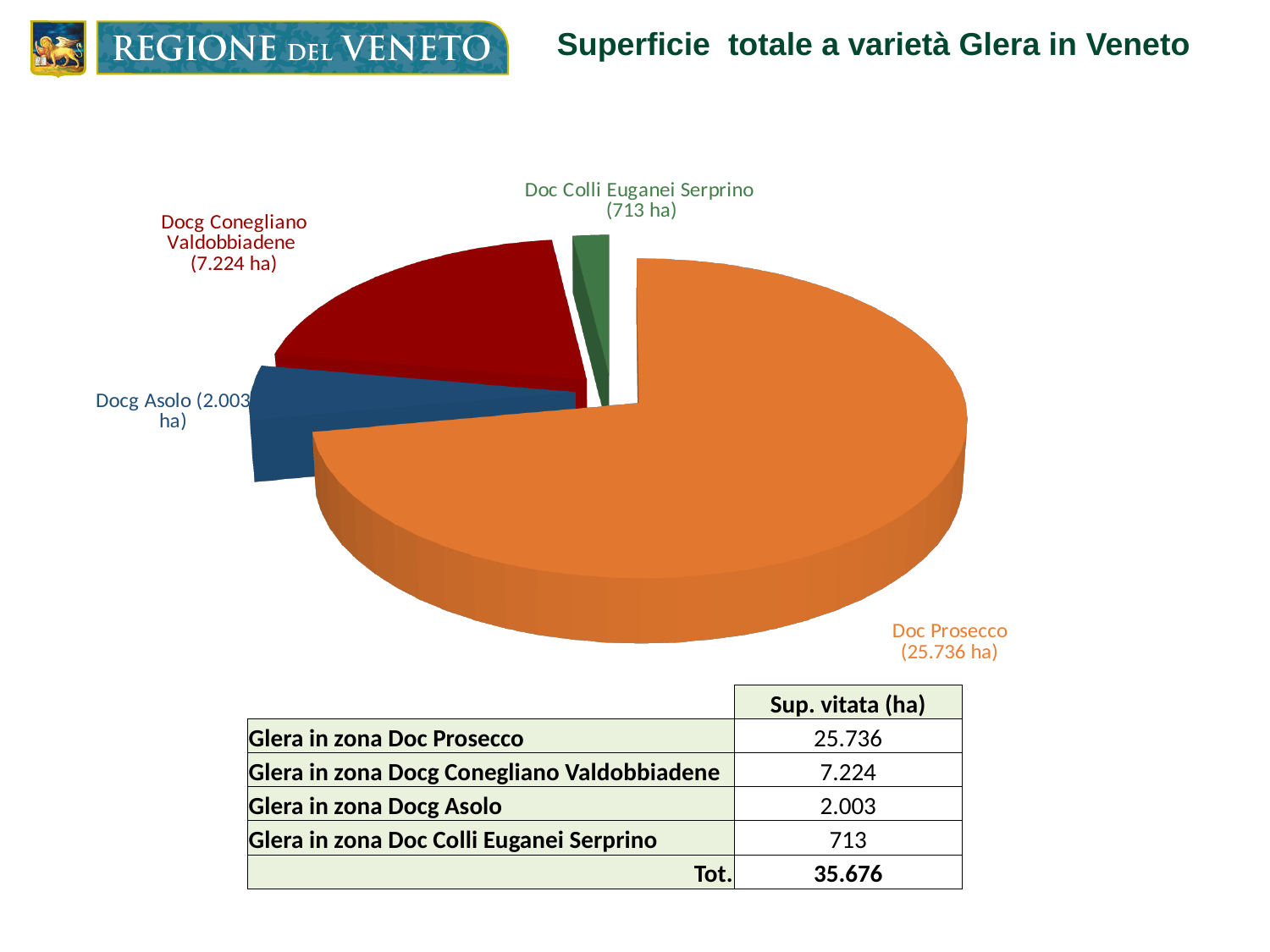
What is the surface area for Docg Conegliano Valdobbiadene? 7.224 ha What is the surface area for Doc Prosecco? 25.736 ha Which zone has the smallest surface area? Doc Colli Euganei Serprino What is the title of the slide's chart? Superficie totale a varietà Glera in Veneto Which zone has the largest surface area? Doc Prosecco What is the total surface area (Tot.) shown in the table? 35.676 ha How many slices does the pie chart have? 4 What kind of chart is shown on the slide? Pie chart What is the surface area for Docg Asolo? 2.003 ha What is the difference in surface area between Doc Prosecco and Docg Conegliano Valdobbiadene? 18.512 ha Which has a larger surface area, Docg Asolo or Docg Conegliano Valdobbiadene? Docg Conegliano Valdobbiadene What is the surface area for Doc Colli Euganei Serprino? 713 ha